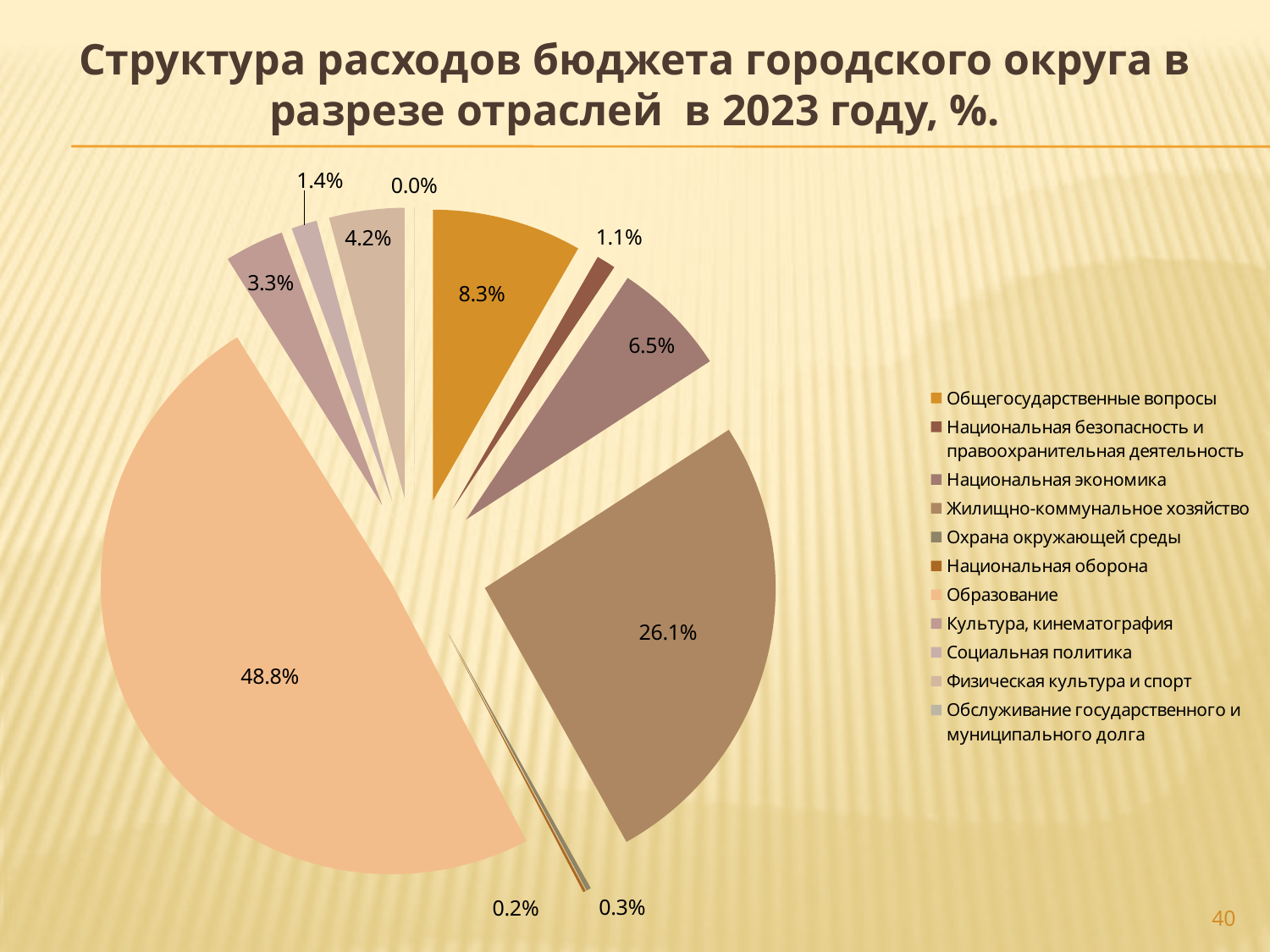
How many categories does the legend list? 11 What share of budget expenditure goes to Общегосударственные вопросы? 8.3% What is the difference in percentage points between the shares of Образование and Жилищно-коммунальное хозяйство? 22.7 What share of budget expenditure goes to Образование? 48.8% What share of budget expenditure goes to Жилищно-коммунальное хозяйство? 26.1% Which category has the smallest share of expenditure? Обслуживание государственного и муниципального долга Which has a larger share: Национальная экономика or Общегосударственные вопросы? Общегосударственные вопросы What share of budget expenditure goes to Физическая культура и спорт? 4.2% Which category has the largest share of expenditure? Образование What share of budget expenditure goes to Культура, кинематография? 3.3% What share of budget expenditure goes to Национальная экономика? 6.5% What kind of chart is shown on the slide? pie chart